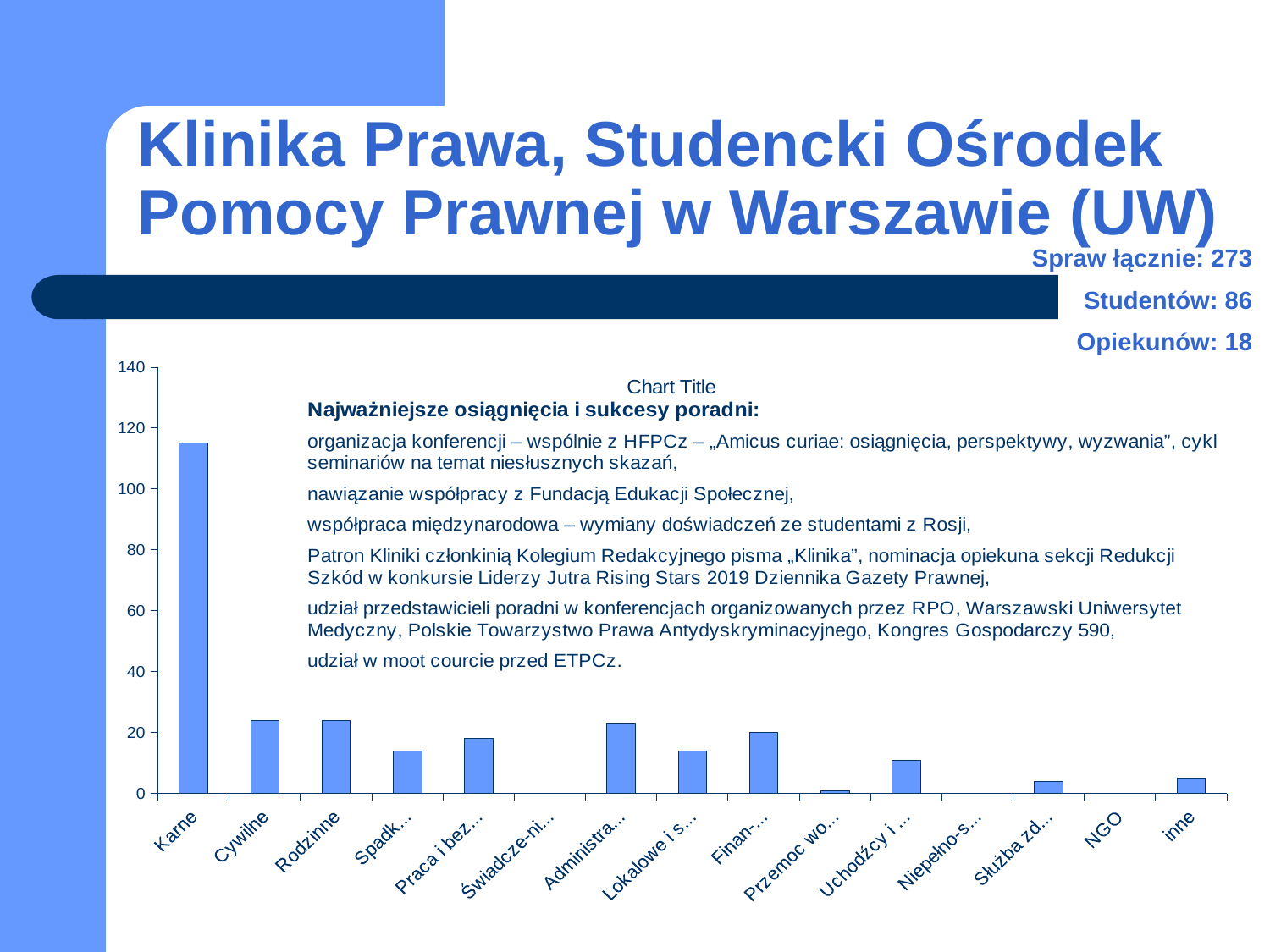
Is the value for Służba zd... greater or less than 20? less Which is larger, the value for Karne or the value for Cywilne? Karne Which category has the highest bar in the chart? Karne Which is larger, the value for Rodzinne or the value for Spadk...? Rodzinne What title is printed above the chart? Chart Title Is the value for Finan-... greater or less than 40? less How many categories are plotted on the x axis of the chart? 15 What kind of chart is shown on the slide? bar chart Is the value for Cywilne greater or less than 40? less Which is larger, the value for Administra... or the value for Uchodźcy i ...? Administra...